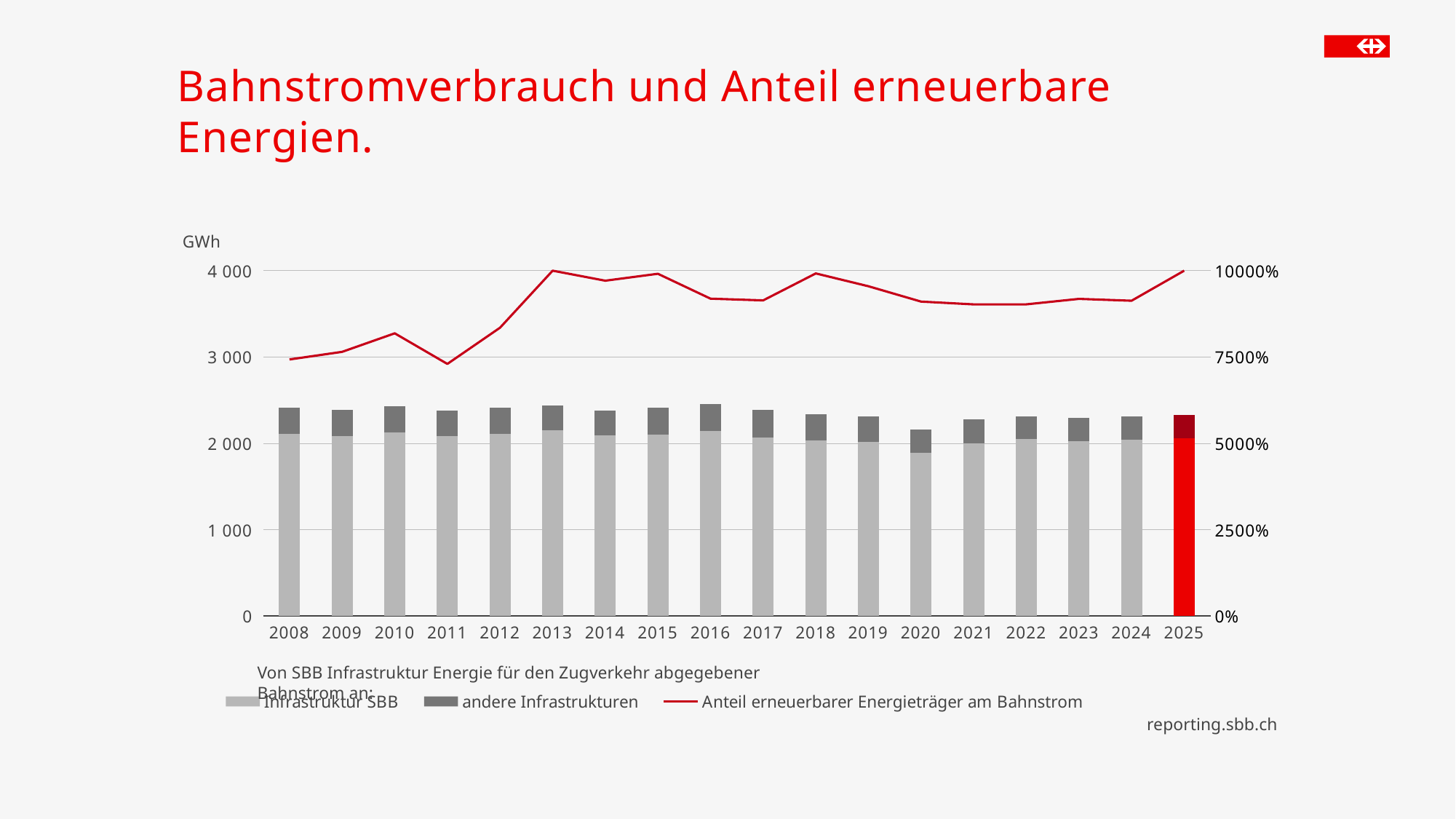
Is the 'Infrastruktur SBB' value for 2020 greater or less than 2 000 GWh? less Is the value of the line 'Anteil erneuerbarer Energieträger am Bahnstrom' in 2013 greater or less than 7500%? greater Does the line 'Anteil erneuerbarer Energieträger am Bahnstrom' rise or fall from 2011 to 2013? rise Which year has the lowest total bar (Bahnstrom consumption)? 2020 What unit is shown on the left vertical axis of the chart? GWh Is the total bar for 2016 greater or less than 2 000 GWh? greater How many years are shown on the x axis of the chart? 18 In which year is the line 'Anteil erneuerbarer Energieträger am Bahnstrom' at its lowest? 2011 How many series does the legend list? 3 Which year has the larger total bar, 2016 or 2020? 2016 What kind of chart is shown on the slide? A stacked bar chart combined with a line chart